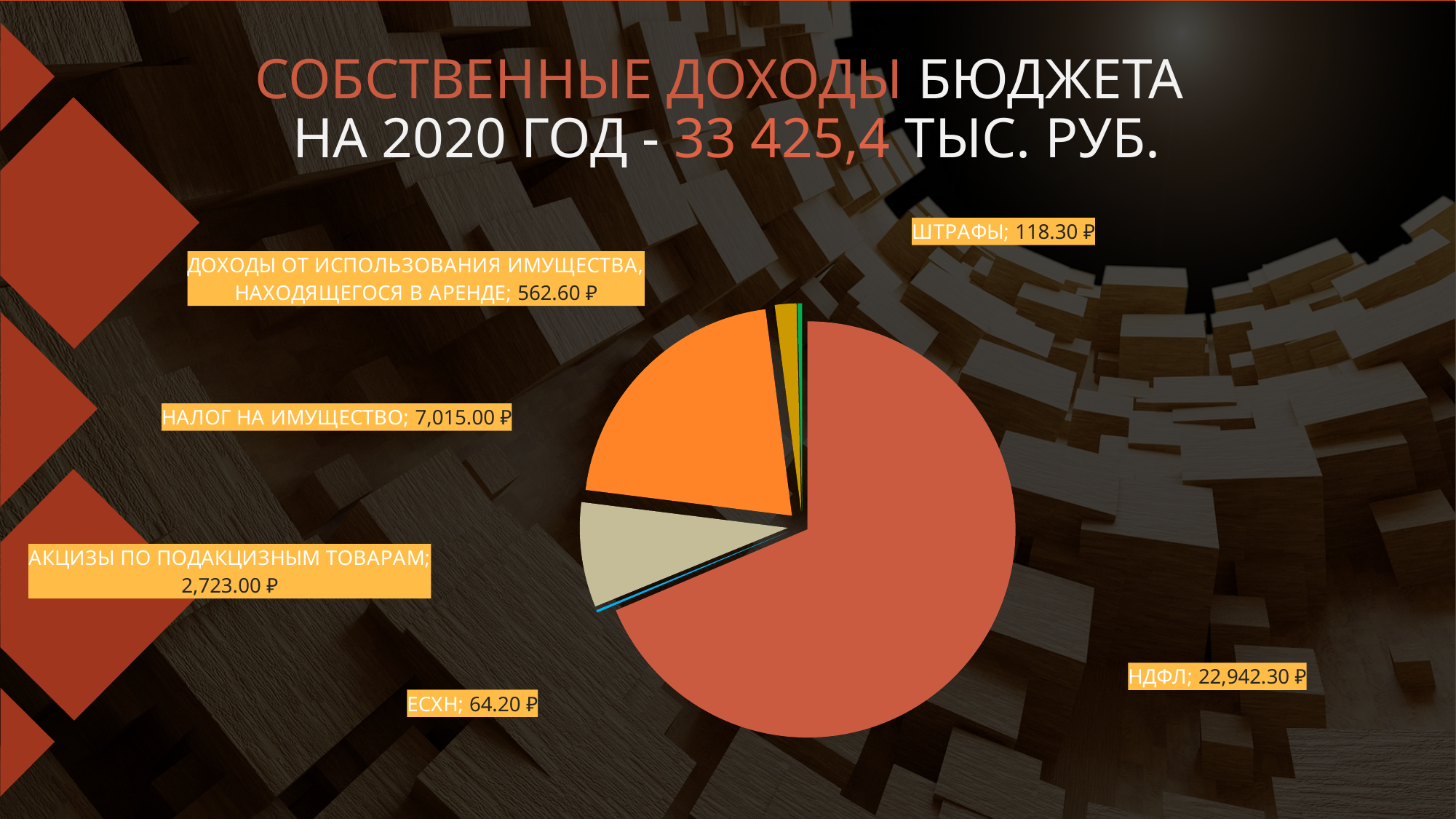
Which category has the smallest value? ЕСХН What is the value for ШТРАФЫ? 118.30 ₽ Which category has the largest slice of the pie? НДФЛ What is the value for АКЦИЗЫ ПО ПОДАКЦИЗНЫМ ТОВАРАМ? 2,723.00 ₽ How many slices does the pie chart have? 6 What is the value for НДФЛ? 22,942.30 ₽ What is the difference between НАЛОГ НА ИМУЩЕСТВО and АКЦИЗЫ ПО ПОДАКЦИЗНЫМ ТОВАРАМ? 4,292.00 ₽ Which is larger, ШТРАФЫ or ЕСХН? ШТРАФЫ According to the slide title, what is the total of the budget's own revenues for 2020? 33 425,4 тыс. руб. What is the value for ДОХОДЫ ОТ ИСПОЛЬЗОВАНИЯ ИМУЩЕСТВА, НАХОДЯЩЕГОСЯ В АРЕНДЕ? 562.60 ₽ What is the value for НАЛОГ НА ИМУЩЕСТВО? 7,015.00 ₽ What kind of chart is shown on the slide? Pie chart